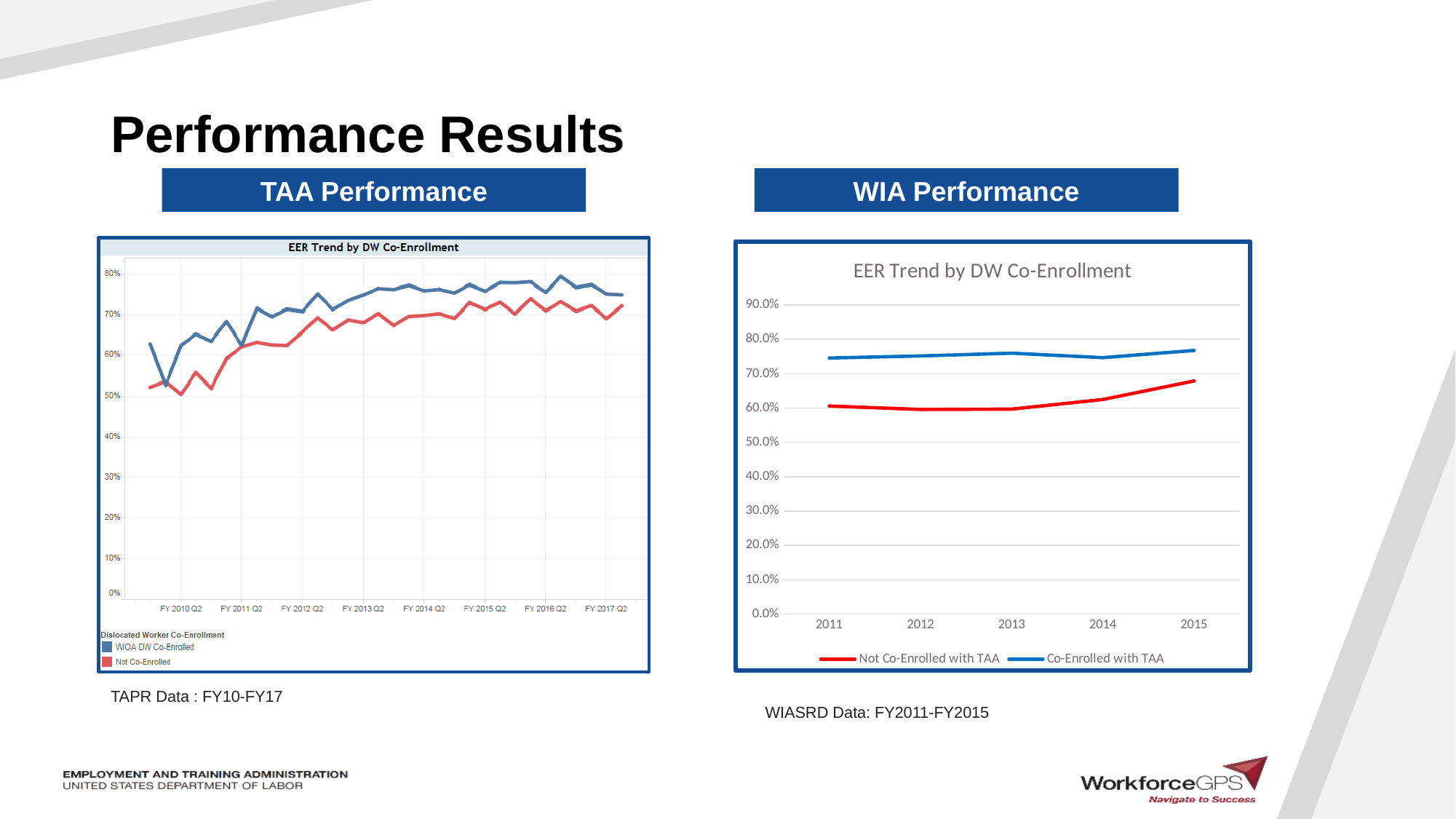
In the WIA Performance chart, does the Not Co-Enrolled with TAA line rise or fall from 2013 to 2015? rise In the WIA Performance chart, which series has the higher value in 2011, Co-Enrolled with TAA or Not Co-Enrolled with TAA? Co-Enrolled with TAA In the WIA Performance chart, how many years are shown on the x axis? 5 In the WIA Performance chart, is the value for Co-Enrolled with TAA in 2015 greater or less than 70.0%? greater In the TAA Performance chart, is the value for Not Co-Enrolled at FY 2010 Q2 greater or less than 60%? less What type of chart is shown under the TAA Performance heading? line chart In the TAA Performance chart, which series is generally higher across the period, WIOA DW Co-Enrolled or Not Co-Enrolled? WIOA DW Co-Enrolled What is the title of the chart under the WIA Performance heading? EER Trend by DW Co-Enrollment What type of chart is shown under the WIA Performance heading? line chart In the WIA Performance chart, how many series does the legend list? 2 In the WIA Performance chart, which colour represents Not Co-Enrolled with TAA? red